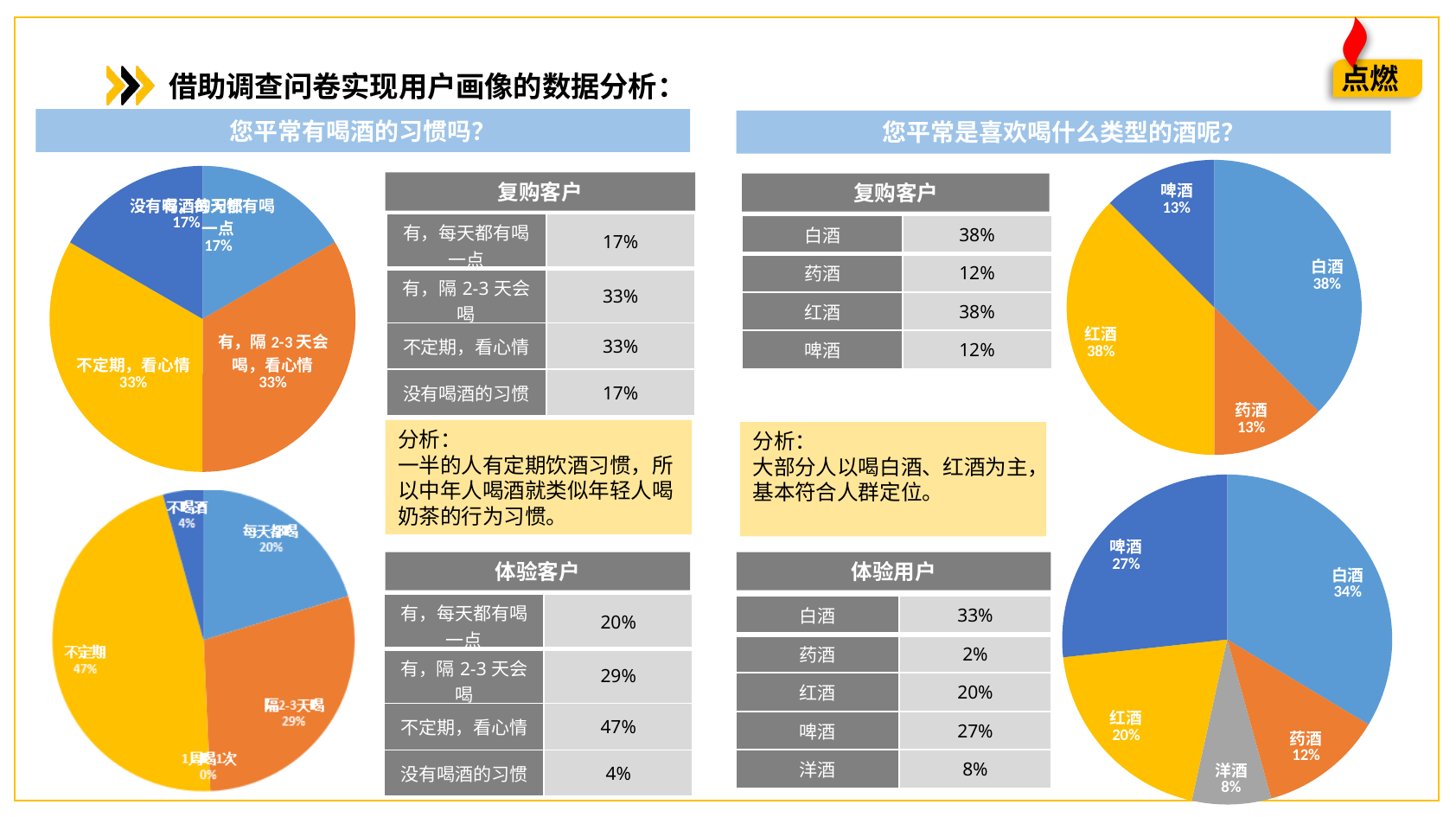
In the top-right pie chart, what share is labelled for 白酒? 38% In the top-left pie chart, what share is labelled for 有，隔 2-3 天会喝，看心情? 33% In the bottom-left pie chart, what is the difference between the shares for 不定期 and 隔2-3天喝? 18% In the bottom-left pie chart, what share is labelled for 不喝酒? 4% In the top-right pie chart, which is larger, the slice for 红酒 or the slice for 啤酒? 红酒 In the top-left pie chart, what share is labelled for 不定期，看心情? 33% In the bottom-left pie chart, which category has the largest slice? 不定期 In the bottom-right pie chart, what share is labelled for 啤酒? 27% How many slices does the bottom-right pie chart have? 5 In the bottom-right pie chart, which category has the smallest slice? 洋酒 What type of chart is used in the top-right of the slide? Pie chart In the bottom-left pie chart, what share is labelled for 不定期? 47%